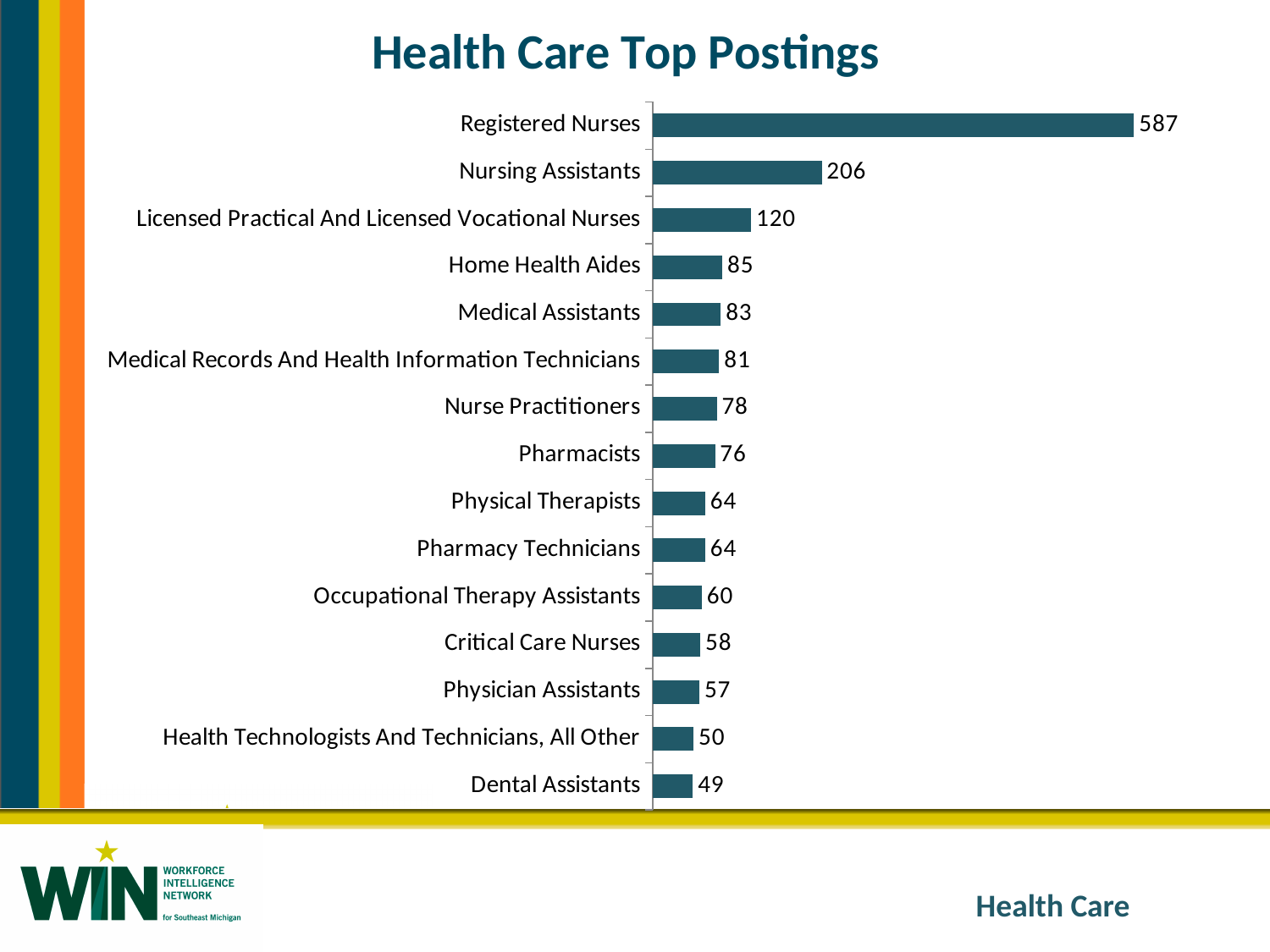
Which is larger, the value for Pharmacists or the value for Physical Therapists? Pharmacists What is the value for Dental Assistants? 49 How many categories are shown in the chart? 15 What is the difference between the values for Registered Nurses and Nursing Assistants? 381 What is the value for Nursing Assistants? 206 What is the title of the chart? Health Care Top Postings What is the value for Registered Nurses? 587 What is the difference between the values for Licensed Practical And Licensed Vocational Nurses and Home Health Aides? 35 What kind of chart is shown on the slide? Bar chart What is the value for Medical Records And Health Information Technicians? 81 Which category has the highest value? Registered Nurses Which category has the lowest value? Dental Assistants